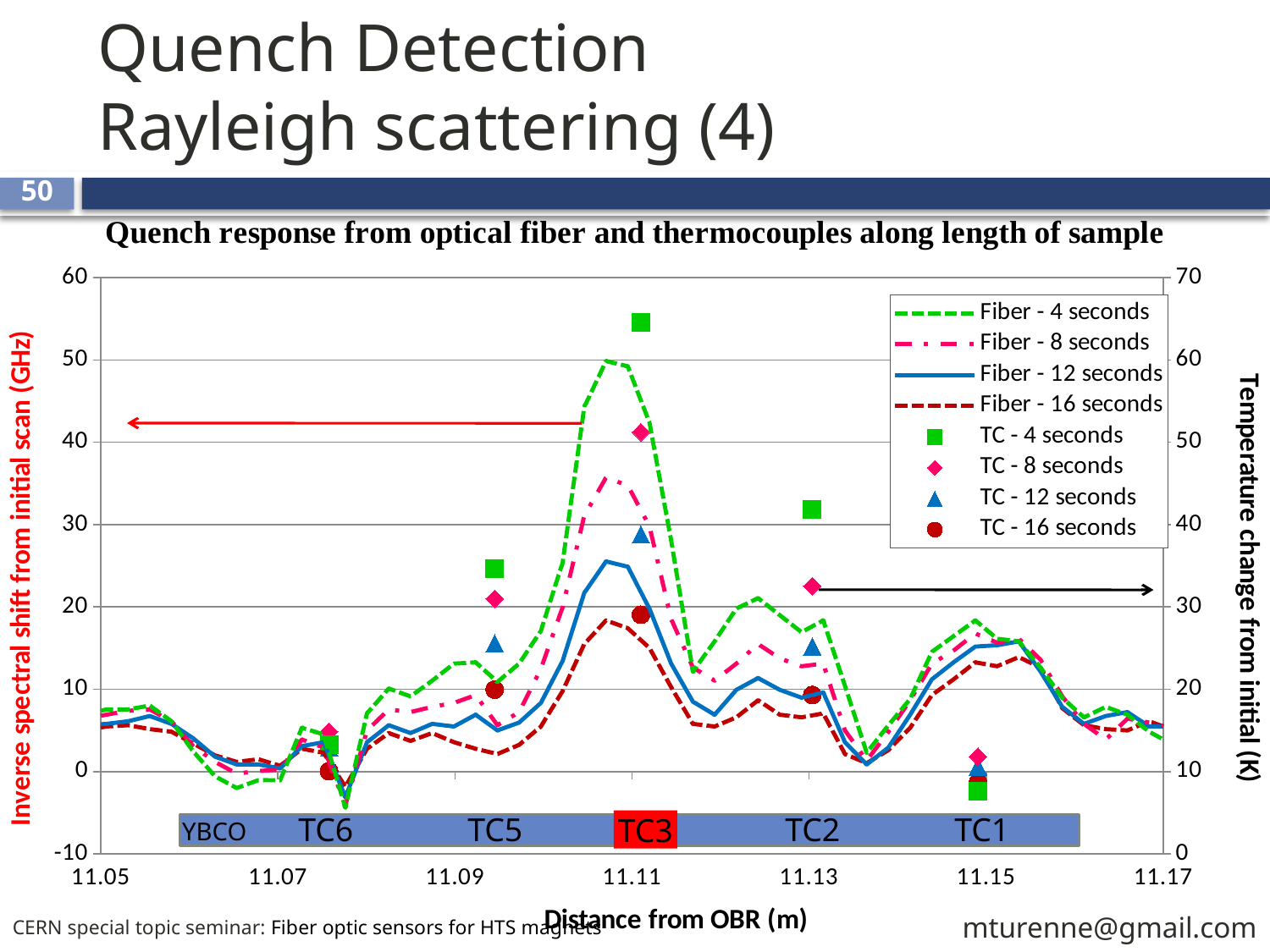
Is the TC - 4 seconds point at TC3 greater or less than 60 on the right axis? greater At TC3, which is larger: the TC - 4 seconds point or the TC - 16 seconds point? TC - 4 seconds Which fiber series has the lowest peak near 11.11 m? Fiber - 16 seconds How many series does the legend list? 8 What kind of chart is shown on the slide? line chart with scatter points Is the peak value of the Fiber - 16 seconds series near 11.11 m greater or less than 20 on the left axis? less Is the TC - 16 seconds point at TC3 greater or less than 40 on the right axis? less What is the title of the chart? Quench response from optical fiber and thermocouples along length of sample What is the label of the x axis? Distance from OBR (m) Which fiber series reaches the highest peak near 11.11 m? Fiber - 4 seconds How many thermocouple positions (TC labels) are marked along the sample bar? 5